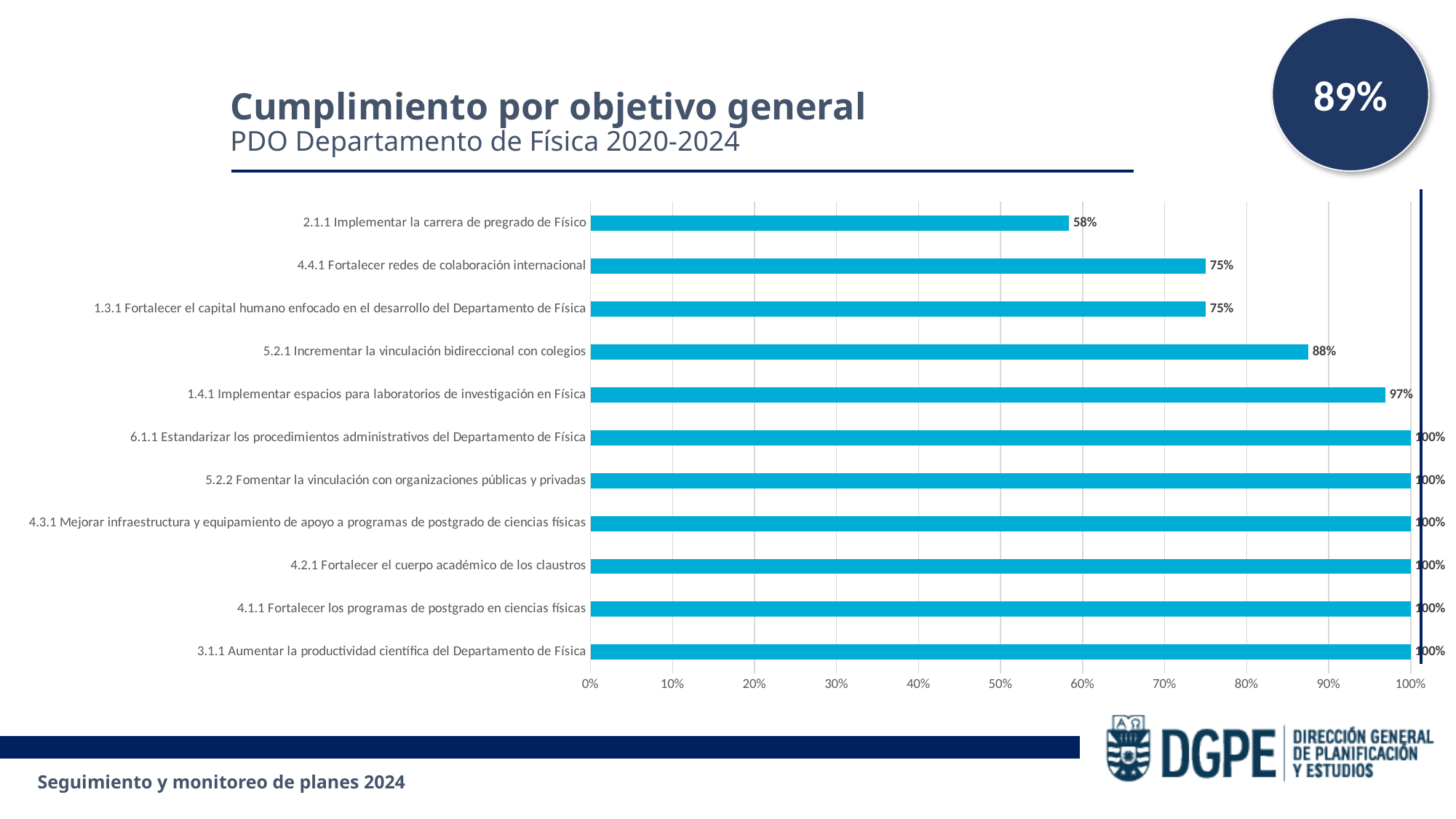
What is the difference between the values for 1.4.1 Implementar espacios para laboratorios de investigación en Física and 2.1.1 Implementar la carrera de pregrado de Físico? 39% How many objectives have a value of 100%? 6 Which is larger, the value for 5.2.1 Incrementar la vinculación bidireccional con colegios or for 1.3.1 Fortalecer el capital humano enfocado en el desarrollo del Departamento de Física? 5.2.1 Incrementar la vinculación bidireccional con colegios What is the title of the chart on the slide? Cumplimiento por objetivo general Is the value for 2.1.1 Implementar la carrera de pregrado de Físico greater or less than 60%? less What is the value for 1.4.1 Implementar espacios para laboratorios de investigación en Física? 97% What is the value for 5.2.1 Incrementar la vinculación bidireccional con colegios? 88% What kind of chart is shown on the slide? bar chart What is the value for 2.1.1 Implementar la carrera de pregrado de Físico? 58% Which objective has the lowest value? 2.1.1 Implementar la carrera de pregrado de Físico What is the value for 4.4.1 Fortalecer redes de colaboración internacional? 75% How many objectives are plotted in the chart? 11